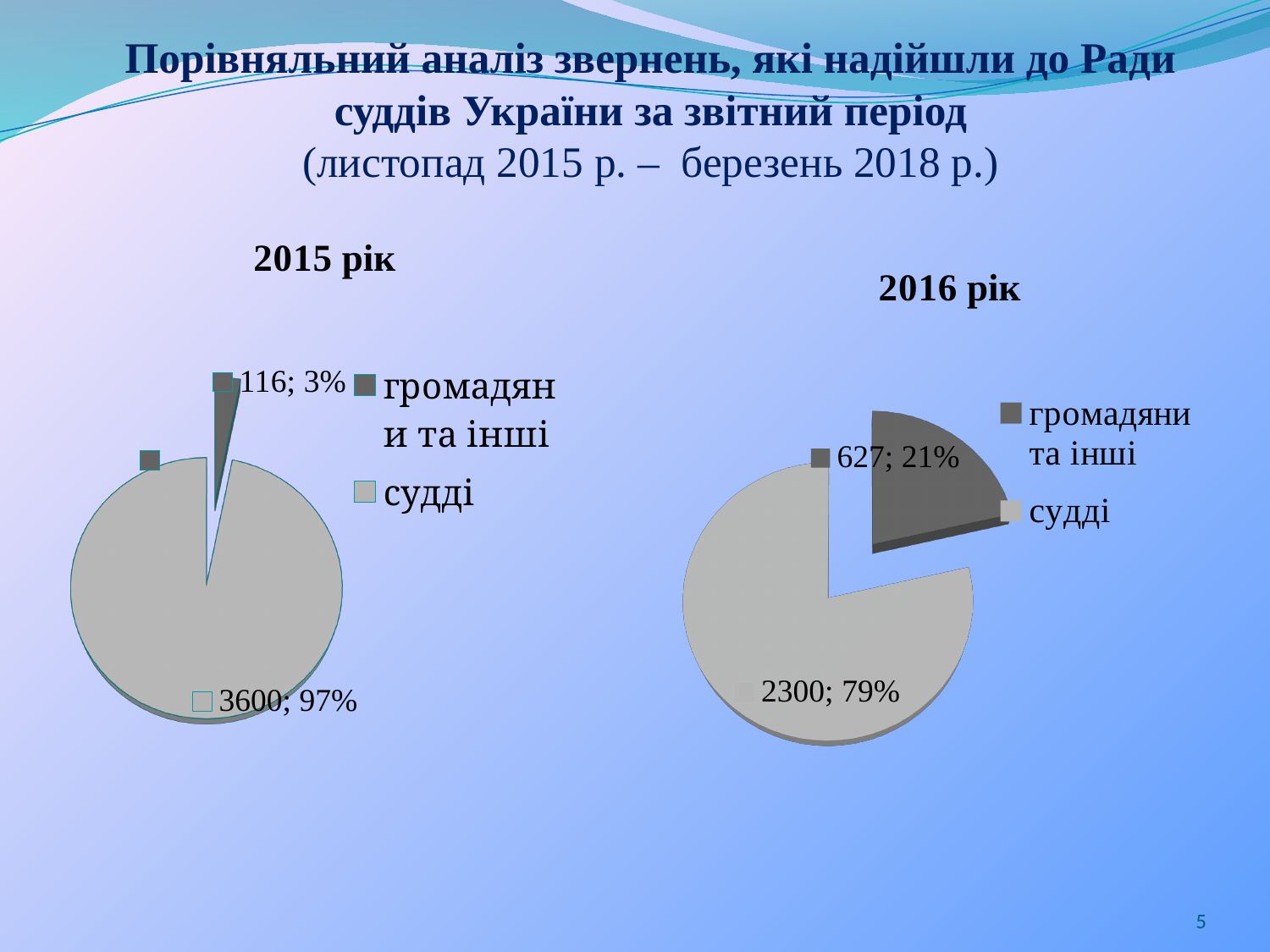
In the "2016 рік" chart, what value is shown for "громадяни та інші"? 627 Which is larger: the value for "громадяни та інші" in the "2015 рік" chart or in the "2016 рік" chart? 2016 рік In the "2016 рік" chart, what value is shown for "судді"? 2300 In the "2015 рік" chart, what value is shown for "судді"? 3600 In the "2015 рік" chart, what share of the pie does "судді" take? 97% How many categories does the "2016 рік" chart show? 2 In the "2016 рік" chart, what is the difference between the values for "судді" and "громадяни та інші"? 1673 In the "2016 рік" chart, what share of the pie does "громадяни та інші" take? 21% In the "2015 рік" chart, what value is shown for "громадяни та інші"? 116 In the "2015 рік" chart, which category has the smallest slice? громадяни та інші What type of chart is the "2015 рік" chart? pie chart In the "2016 рік" chart, which category has the largest slice? судді